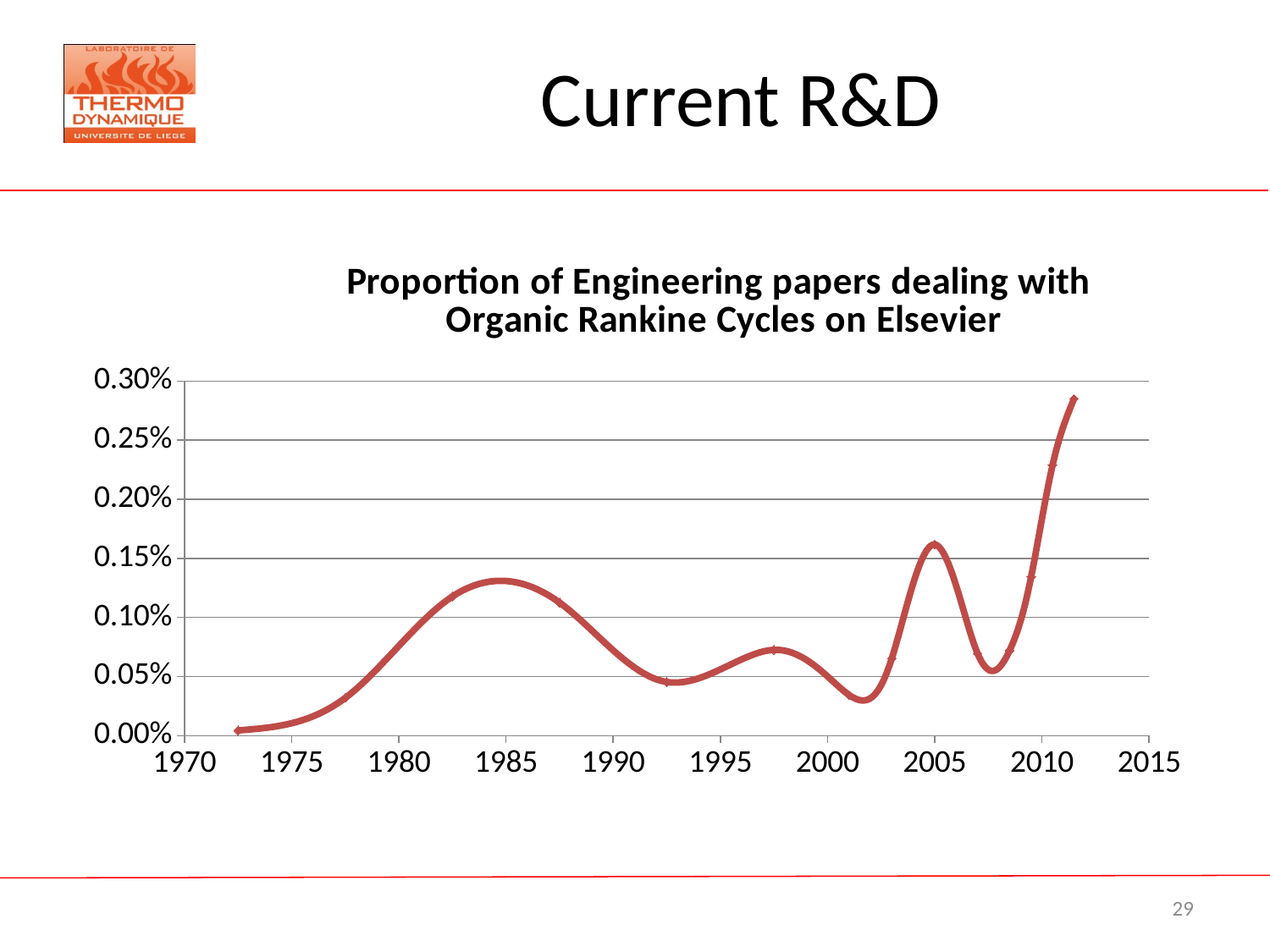
Is the value of the line around 1998 greater or less than 0.05%? greater Overall, does the proportion rise or fall from the early 1970s to the early 2010s? rise Is the value of the line around 1973 greater or less than 0.05%? less What kind of chart is shown on the slide? line chart Is the value of the line around 1985 greater or less than 0.10%? greater What is the highest value shown on the vertical axis of the chart? 0.30% Around which year does the line reach its highest value? around 2011 Around which year does the line have its lowest value? around 1973 Which is larger: the peak of the line around 2005 or the peak around 1985? the peak around 2005 What is the title of the chart? Proportion of Engineering papers dealing with Organic Rankine Cycles on Elsevier